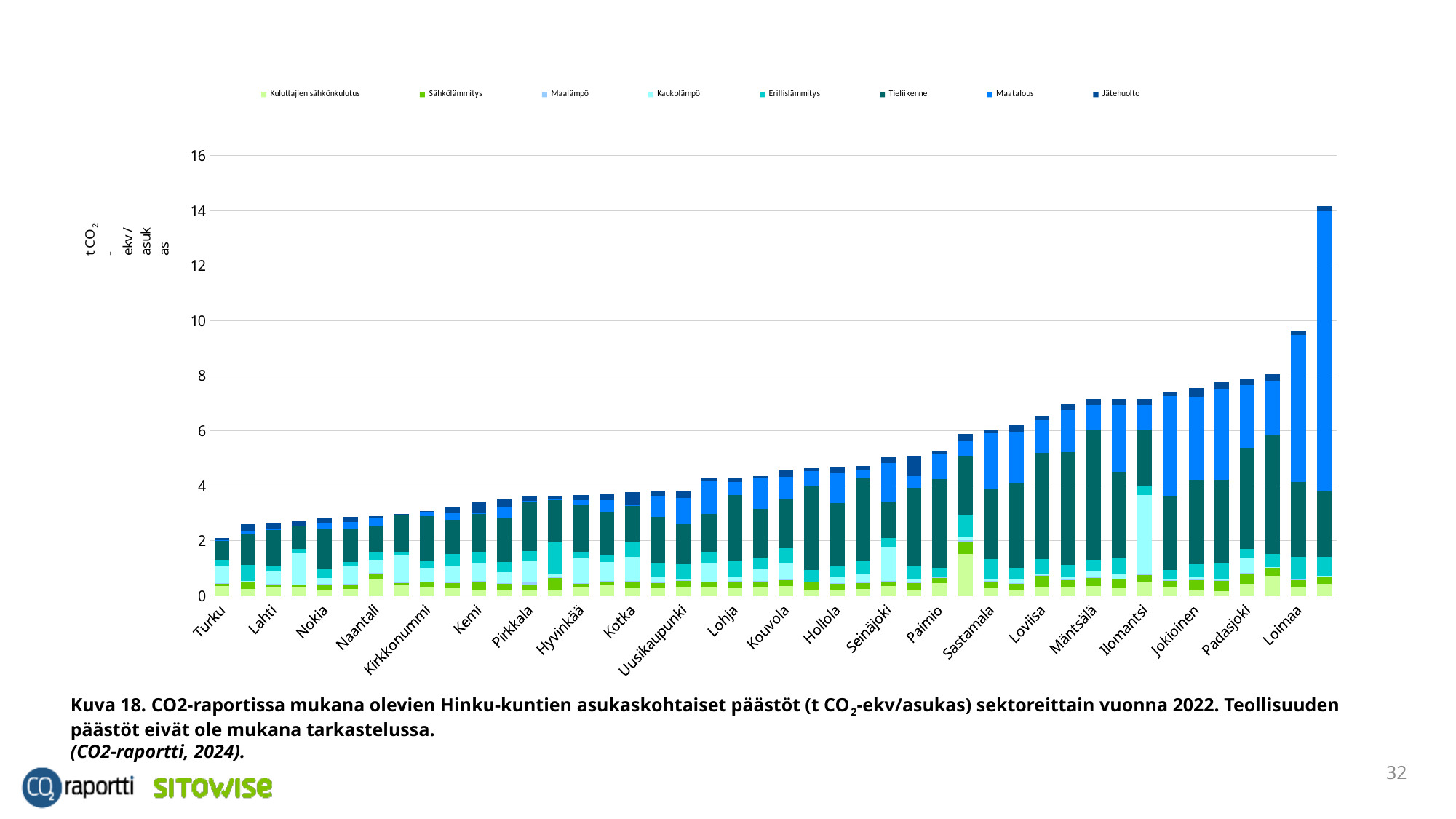
Which has the larger total, Mäntsälä or Lahti? Mäntsälä Is the total value for Padasjoki greater or less than 10? less Do the total bar heights rise or fall from left to right along the x axis? Rise Which series is listed first in the legend? Kuluttajien sähkönkulutus Is the total value for Turku greater or less than 4? less Is the total value for Loimaa greater or less than 12? less Which municipality has the lowest total emissions per inhabitant? Turku What kind of chart is shown on the slide? Stacked bar chart Which series is shown in bright blue and forms the large top segment of the Loimaa bar? Maatalous How many series does the legend list? 8